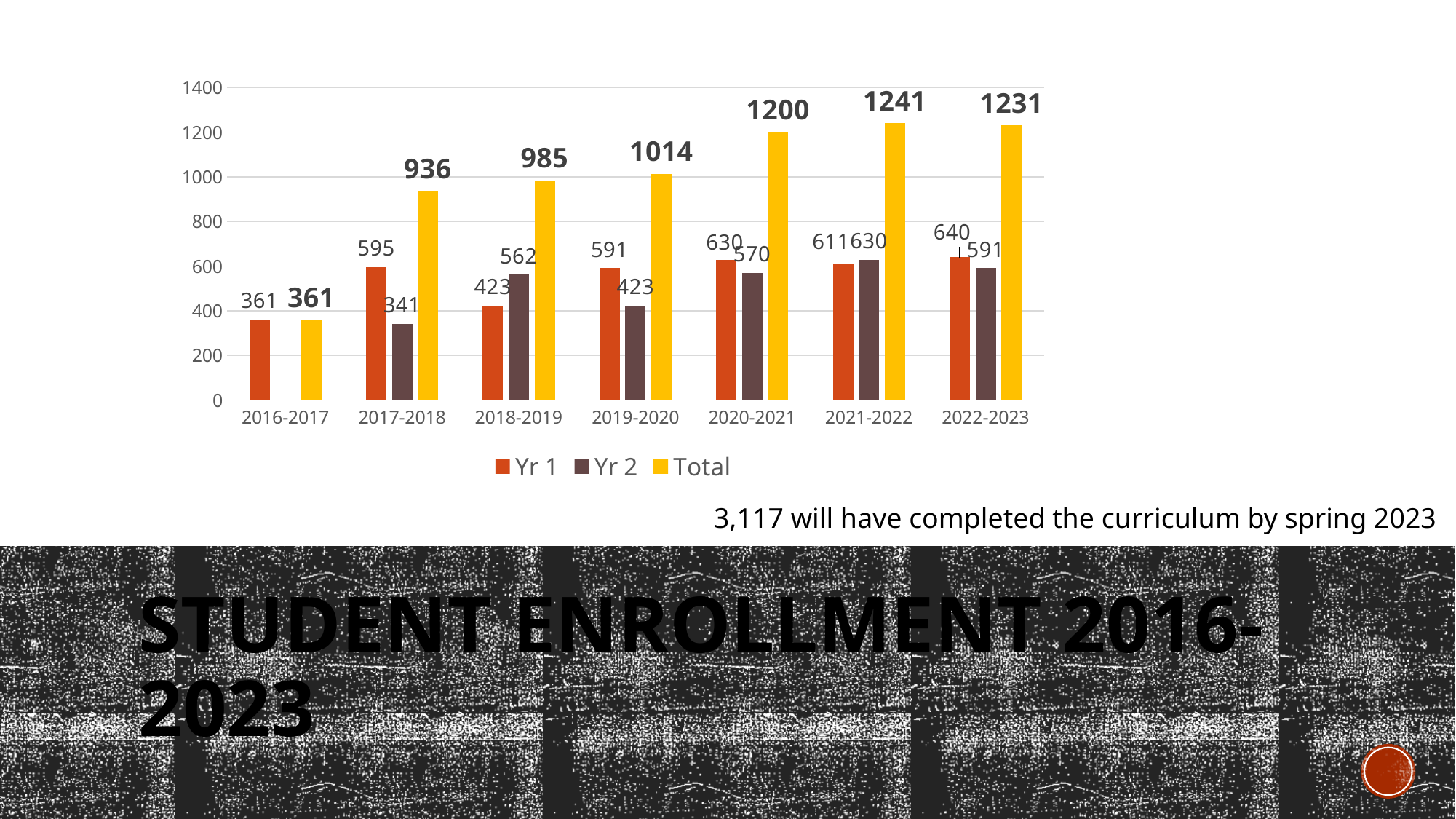
What kind of chart is shown on the slide? bar chart Which is larger, the Yr 1 value for 2022-2023 or the Yr 2 value for 2022-2023? Yr 1 value for 2022-2023 Which year has the highest Total value? 2021-2022 What is the Yr 2 value for 2018-2019? 562 How many series does the legend list? 3 What is the Yr 1 value for 2017-2018? 595 Which series is shown in yellow in the legend? Total What is the difference between the Total values for 2020-2021 and 2019-2020? 186 Which year has the lowest Total value? 2016-2017 What is the Total value for 2021-2022? 1241 How many year categories are shown on the x axis? 7 Is the Total value for 2018-2019 greater or less than 1000? less